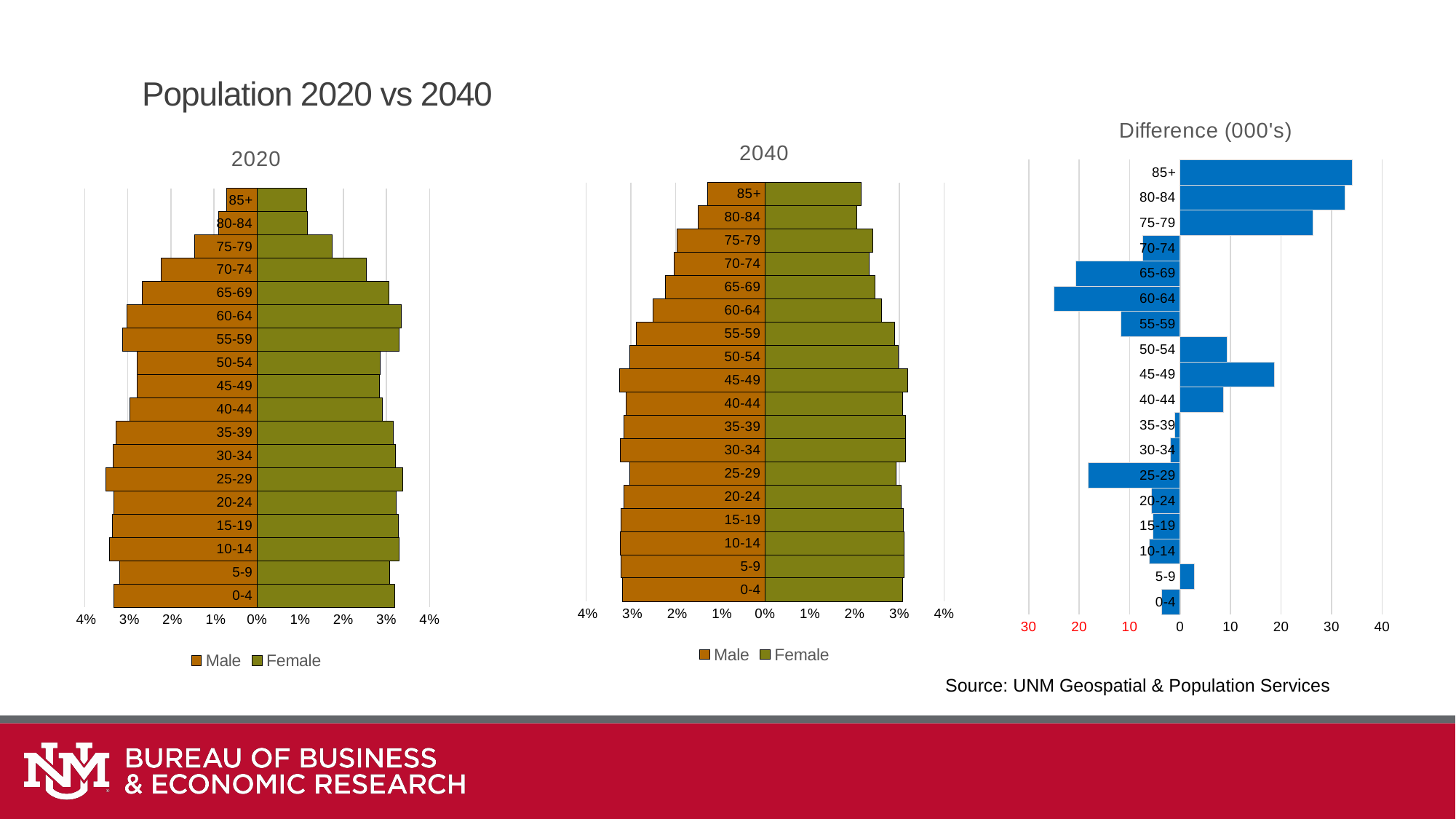
In the 'Difference (000's)' chart, is the value for 25-29 greater or less than -10? less How many series does the legend of the '2040' chart list? 2 In the 'Difference (000's)' chart, is the value for 85+ greater or less than 30? greater What kind of chart is the '2020' chart? Bar chart In the 'Difference (000's)' chart, which age group has the lowest value? 60-64 In the 'Difference (000's)' chart, is the value for 45-49 greater or less than 10? greater How many age groups are shown in the '2020' chart? 18 In the 'Difference (000's)' chart, which age group has the highest value? 85+ In the '2020' chart, which is larger for the 85+ age group, the Male value or the Female value? Female In the 'Difference (000's)' chart, which is larger, the value for 75-79 or the value for 45-49? 75-79 In the 'Difference (000's)' chart, which is larger, the value for 45-49 or the value for 50-54? 45-49